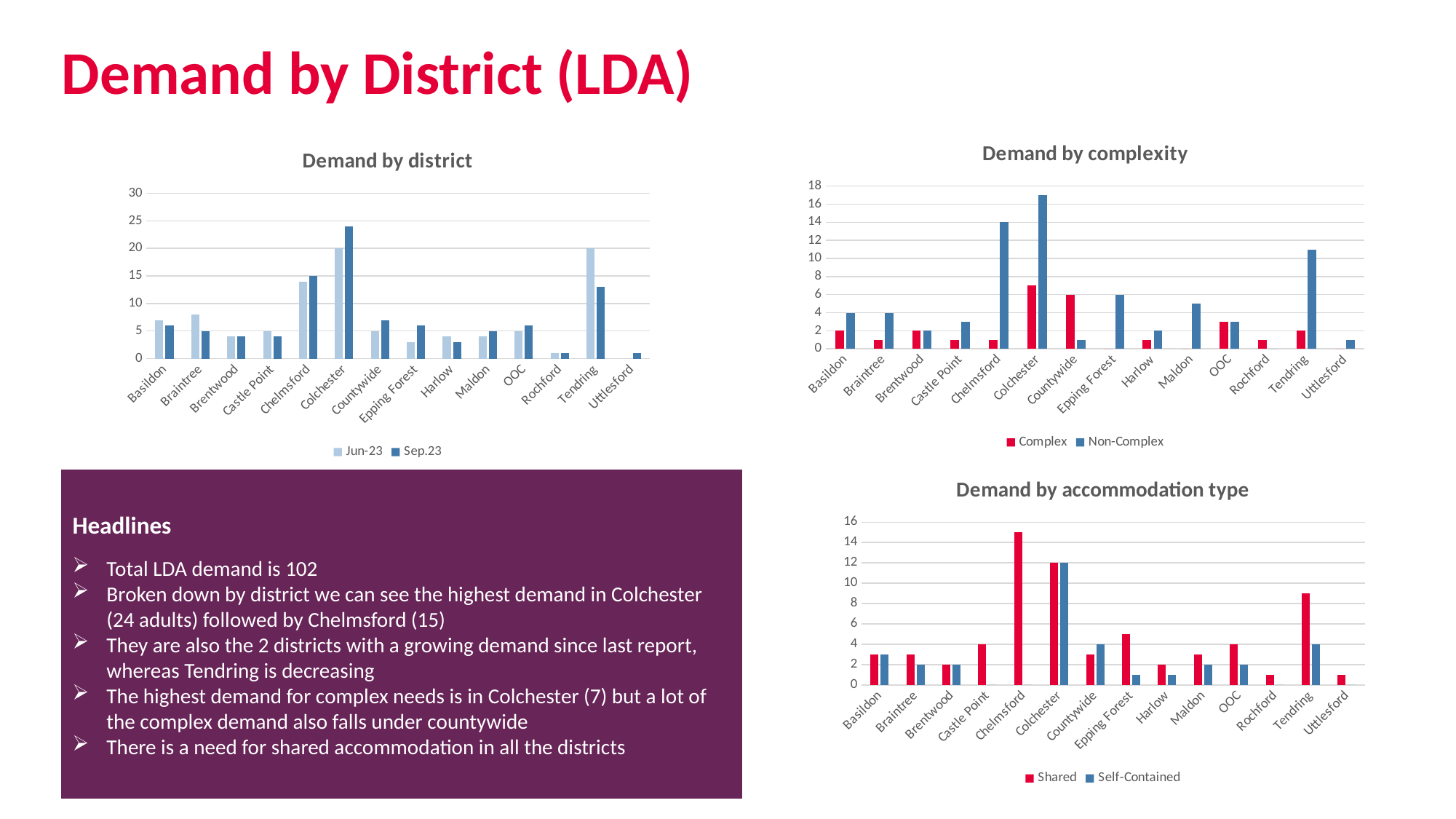
In the 'Demand by accommodation type' chart, how many districts are shown on the x axis? 14 In the 'Demand by complexity' chart, how many series does the legend list? 2 What kind of chart is the 'Demand by district' chart? bar chart In the 'Demand by district' chart, what is the Jun-23 value for Tendring? 20 In the 'Demand by accommodation type' chart, what is the Self-Contained value for Colchester? 12 In the 'Demand by accommodation type' chart, which district has the highest Shared value? Chelmsford In the 'Demand by complexity' chart, which district has the highest Non-Complex value? Colchester In the 'Demand by district' chart, which district has the highest Sep.23 value? Colchester In the 'Demand by district' chart, is the Tendring value larger for Jun-23 or Sep.23? Jun-23 In the 'Demand by complexity' chart, what is the Non-Complex value for Chelmsford? 14 In the 'Demand by complexity' chart, is the Non-Complex value for Colchester greater or less than 16? greater In the 'Demand by district' chart, what is the Sep.23 value for Chelmsford? 15